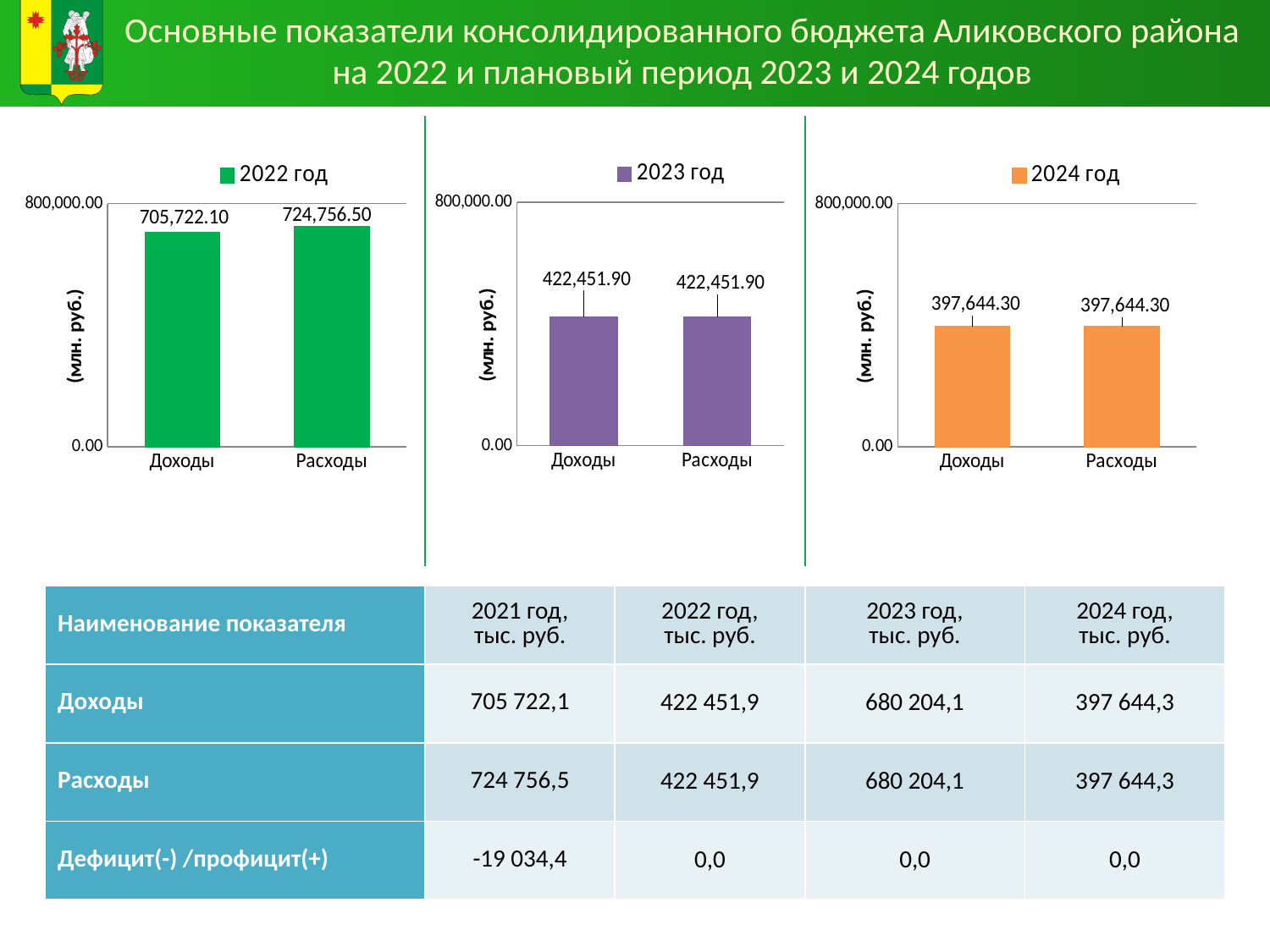
What is the y-axis label of the right chart titled "2024 год"? (млн. руб.) In the middle chart titled "2023 год", what is the value for Доходы? 422,451.90 In the left chart titled "2022 год", which category has the higher value, Доходы or Расходы? Расходы In the right chart titled "2024 год", what is the value for Доходы? 397,644.30 What type of chart is the left chart titled "2022 год"? bar chart In the right chart titled "2024 год", is the value for Расходы greater or less than 800,000.00? less In the middle chart titled "2023 год", what is the value for Расходы? 422,451.90 In the right chart titled "2024 год", what is the value for Расходы? 397,644.30 In the left chart titled "2022 год", what is the value for Расходы? 724,756.50 In the left chart titled "2022 год", what is the difference between Расходы and Доходы? 19,034.40 In the left chart titled "2022 год", what is the value for Доходы? 705,722.10 How many categories are shown on the x axis of the middle chart titled "2023 год"? 2